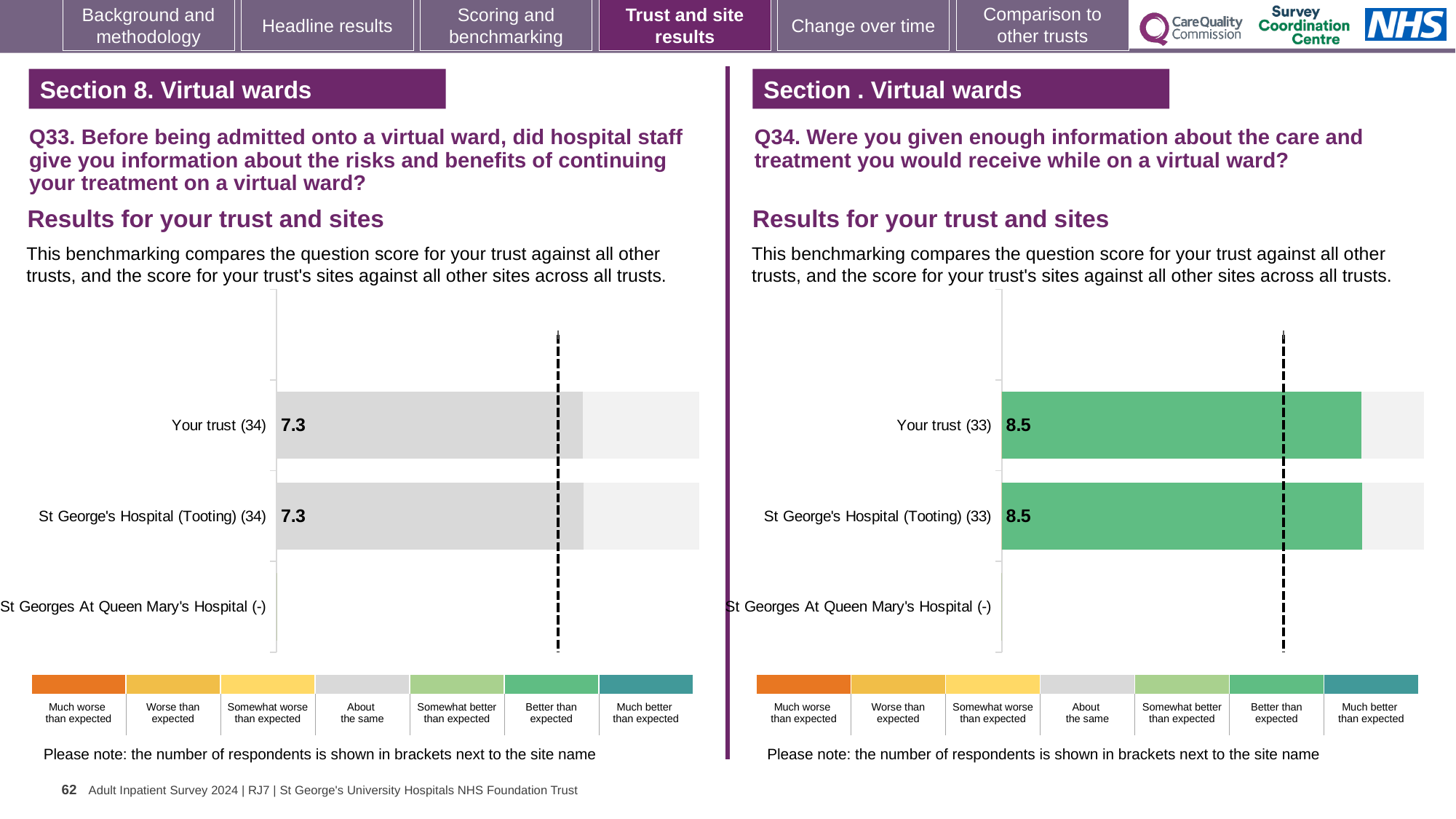
On the left chart (Q33), which category has no bar plotted? St Georges At Queen Mary's Hospital (-) On the right chart (Q34), what colour are the bars for Your trust (33) and St George's Hospital (Tooting) (33)? Green On the left chart (Q33), what is the score for St George's Hospital (Tooting) (34)? 7.3 Is the score for Your trust (33) on the right chart (Q34) larger or smaller than the score for Your trust (34) on the left chart (Q33)? Larger On the right chart (Q34), what is the score for Your trust (33)? 8.5 On the left chart (Q33), how many respondents are shown in brackets for Your trust? 34 On the left chart (Q33), what is the score for Your trust (34)? 7.3 On the right chart (Q34), how many site or trust categories are listed on the vertical axis? 3 On the left chart (Q33), how many site or trust categories are listed on the vertical axis? 3 What kind of chart is used on the left (Q33) to show the results? Bar chart On the right chart (Q34), what is the score for St George's Hospital (Tooting) (33)? 8.5 On the right chart (Q34), what is the difference between the score for Your trust (33) and the score for St George's Hospital (Tooting) (33)? 0